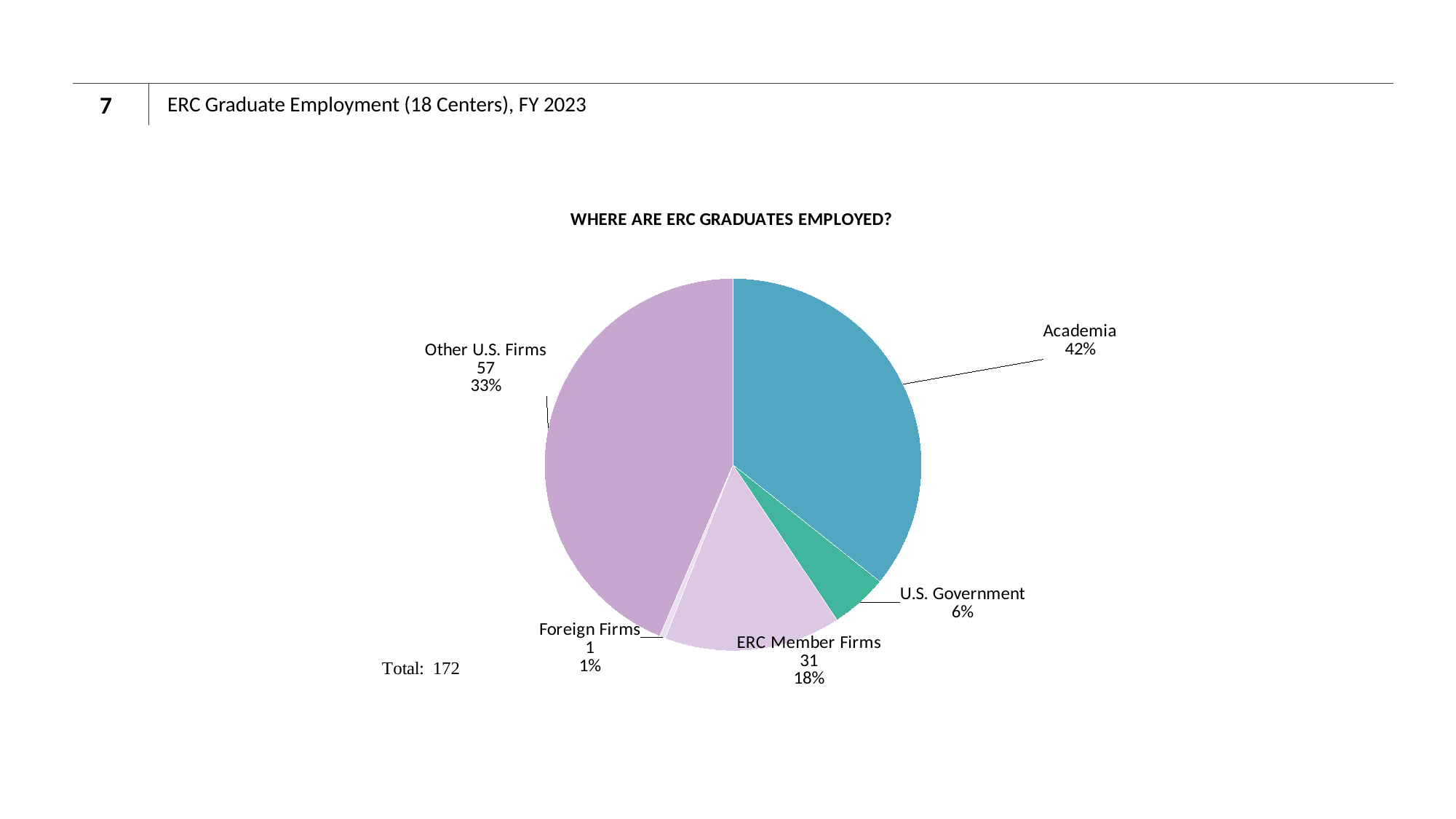
What is the title of the chart? WHERE ARE ERC GRADUATES EMPLOYED? How many ERC graduates are employed by ERC Member Firms? 31 What share of ERC graduates are employed by the U.S. Government? 6% What is the difference between the number of graduates at Other U.S. Firms and at ERC Member Firms? 26 Which employment category has the largest share of ERC graduates? Academia Which employment category has the smallest share of ERC graduates? Foreign Firms What share of ERC graduates are employed in Academia? 42% How many slices does the pie chart have? 5 What kind of chart is shown on the slide? pie chart How many ERC graduates are employed by Other U.S. Firms? 57 What share of ERC graduates are employed by Other U.S. Firms? 33% How many ERC graduates are employed by Foreign Firms? 1